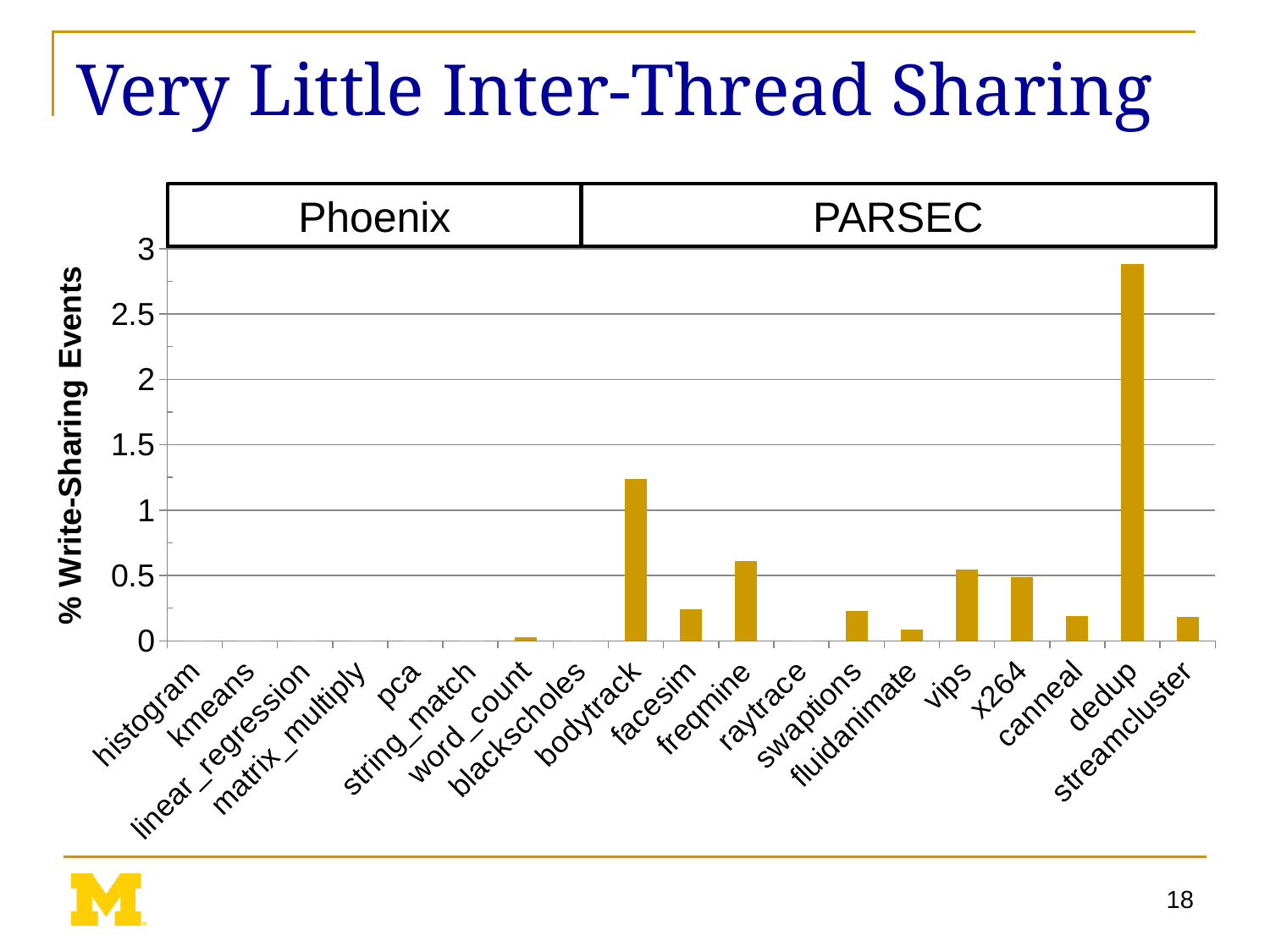
What kind of chart is shown on the slide? bar chart Which benchmark has the highest % Write-Sharing Events? dedup Is the value for bodytrack greater or less than 1? greater Is the value for facesim greater or less than 0.5? less How many benchmark categories are plotted along the x axis? 19 Which has a higher % Write-Sharing Events, bodytrack or freqmine? bodytrack Which has a higher % Write-Sharing Events, facesim or vips? vips What is the label of the y axis? % Write-Sharing Events Is the value for dedup greater or less than 2.5? greater What are the two benchmark suite groups labelled above the chart? Phoenix and PARSEC